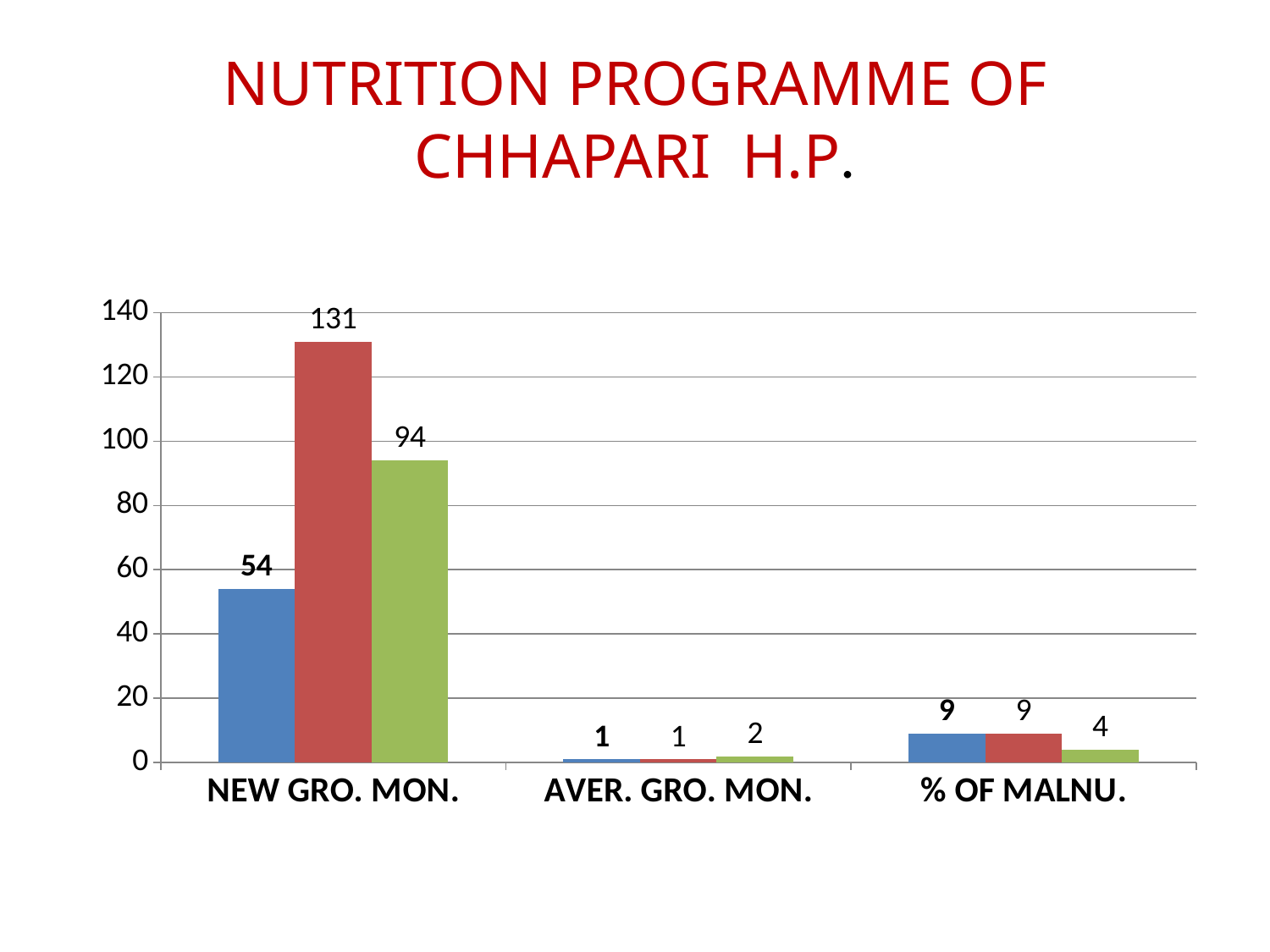
Which is larger for NEW GRO. MON., the green bar or the blue bar? the green bar What is the title of the slide containing the chart? NUTRITION PROGRAMME OF CHHAPARI H.P. What kind of chart is shown on the slide? bar chart What is the value of the green bar for NEW GRO. MON.? 94 Which bar in the NEW GRO. MON. category is the highest? the red bar (131) How many categories are shown on the x axis of the chart? 3 What is the value of the red bar for NEW GRO. MON.? 131 What is the value of the green bar for AVER. GRO. MON.? 2 What is the value of the blue bar for NEW GRO. MON.? 54 What is the value of the green bar for % OF MALNU.? 4 What is the difference between the red bar and the blue bar for NEW GRO. MON.? 77 What is the difference between the red bar and the green bar for % OF MALNU.? 5